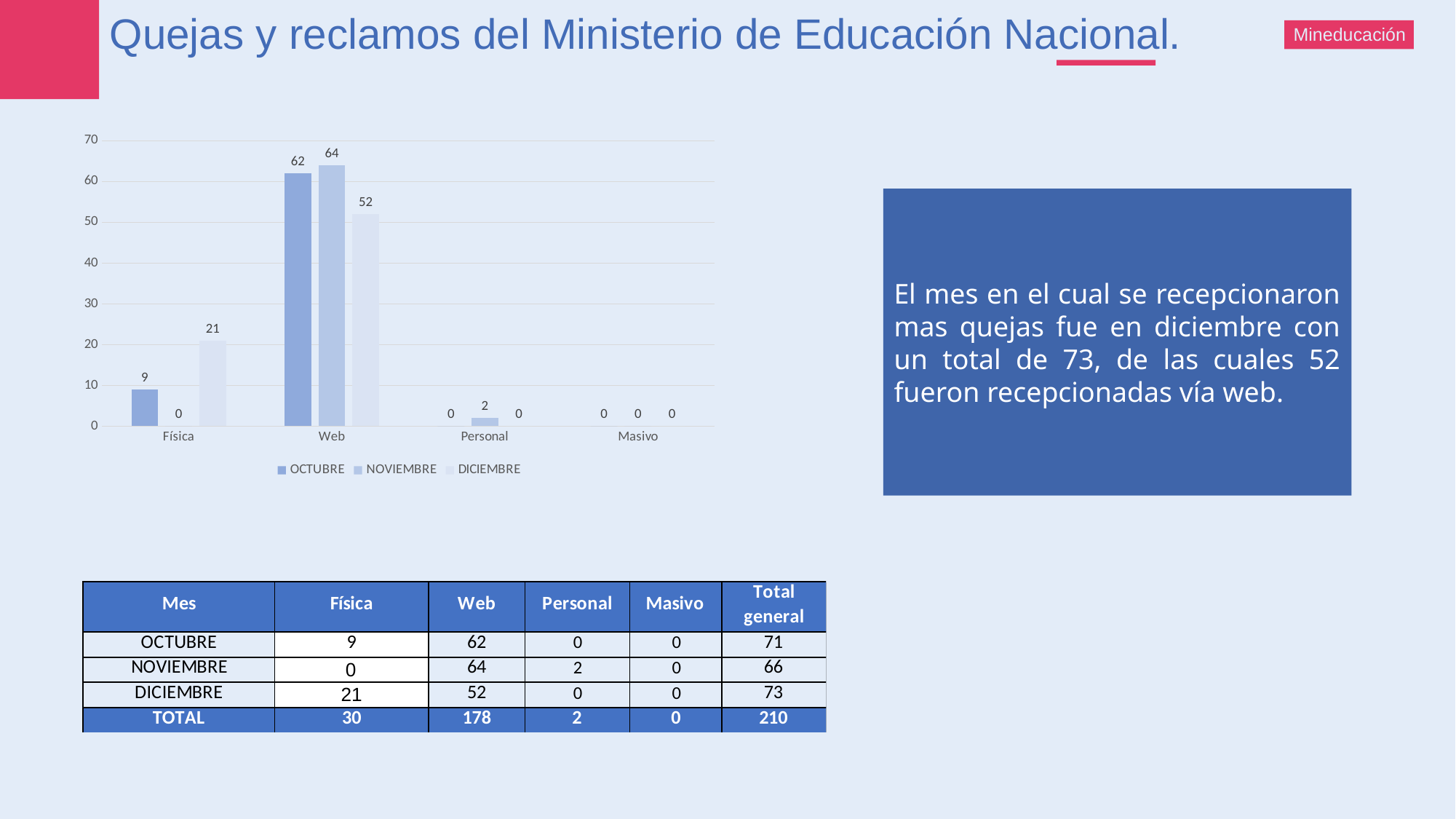
Is the value for Web in the DICIEMBRE series greater or less than 60? less What is the difference between the NOVIEMBRE and DICIEMBRE values for Web? 12 What kind of chart is shown on the slide? bar chart What is the value for Web in the OCTUBRE series? 62 What is the value for Física in the DICIEMBRE series? 21 Which series has the lowest value for Web? DICIEMBRE How many categories are shown on the x axis of the chart? 4 What are the three series listed in the chart legend? OCTUBRE, NOVIEMBRE, DICIEMBRE Which is larger for Física: the OCTUBRE value or the DICIEMBRE value? DICIEMBRE How many series does the chart legend list? 3 Which category has the highest value in the NOVIEMBRE series? Web What is the value for Personal in the NOVIEMBRE series? 2